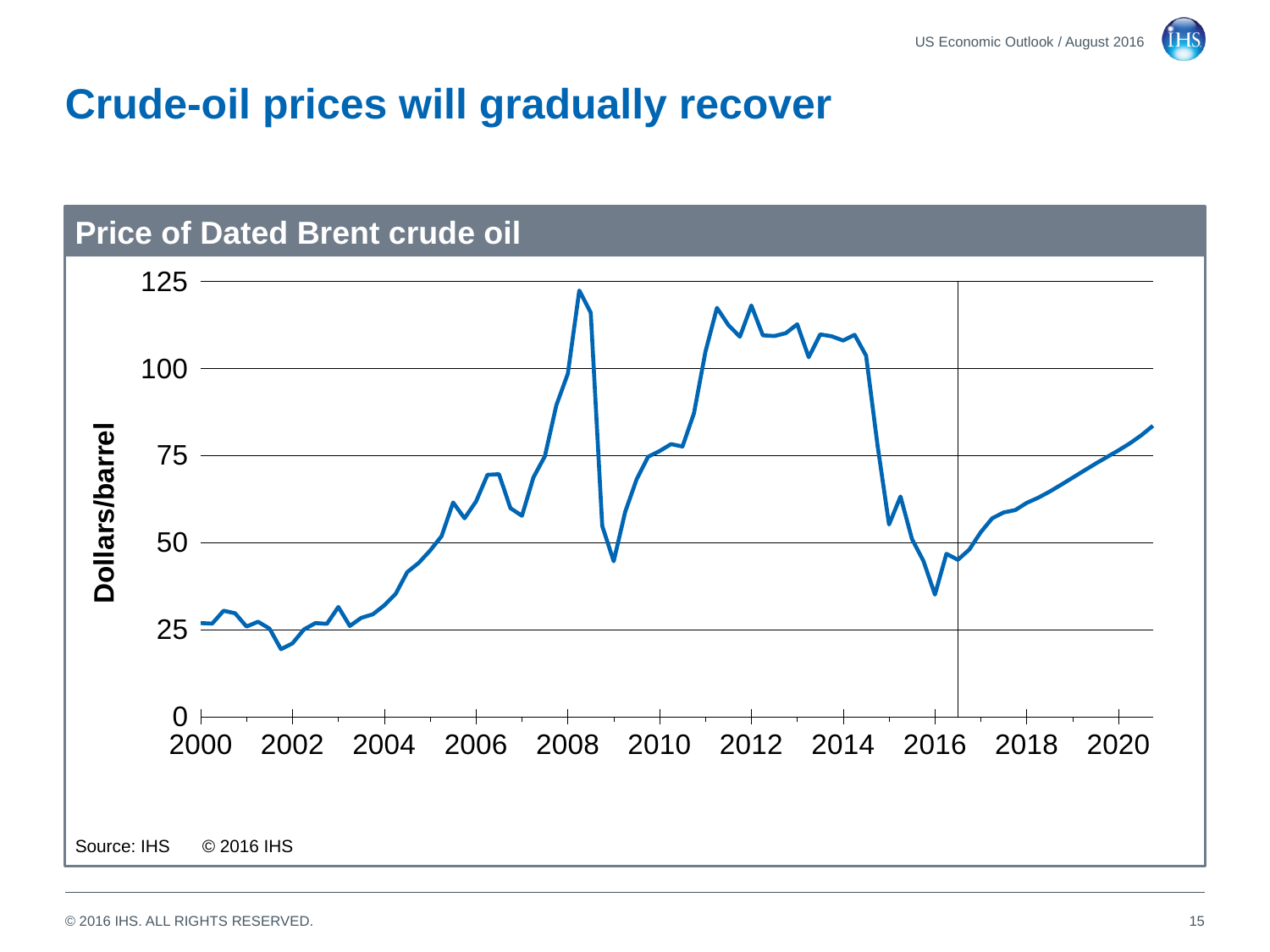
Is the price of Dated Brent crude oil in 2004 greater or less than 50 dollars/barrel? less Around which year does the price of Dated Brent crude oil reach its highest point? 2008 What kind of chart is shown on the slide? line chart Is the price of Dated Brent crude oil in 2014 greater or less than 100 dollars/barrel? greater Is the price of Dated Brent crude oil in 2012 greater or less than 100 dollars/barrel? greater What is the label on the vertical axis of the chart? Dollars/barrel What is the title of the chart? Price of Dated Brent crude oil Does the price of Dated Brent crude oil rise or fall between 2014 and 2016? fall Does the price of Dated Brent crude oil rise or fall between 2016 and 2020? rise What is the highest value shown on the vertical axis of the chart? 125